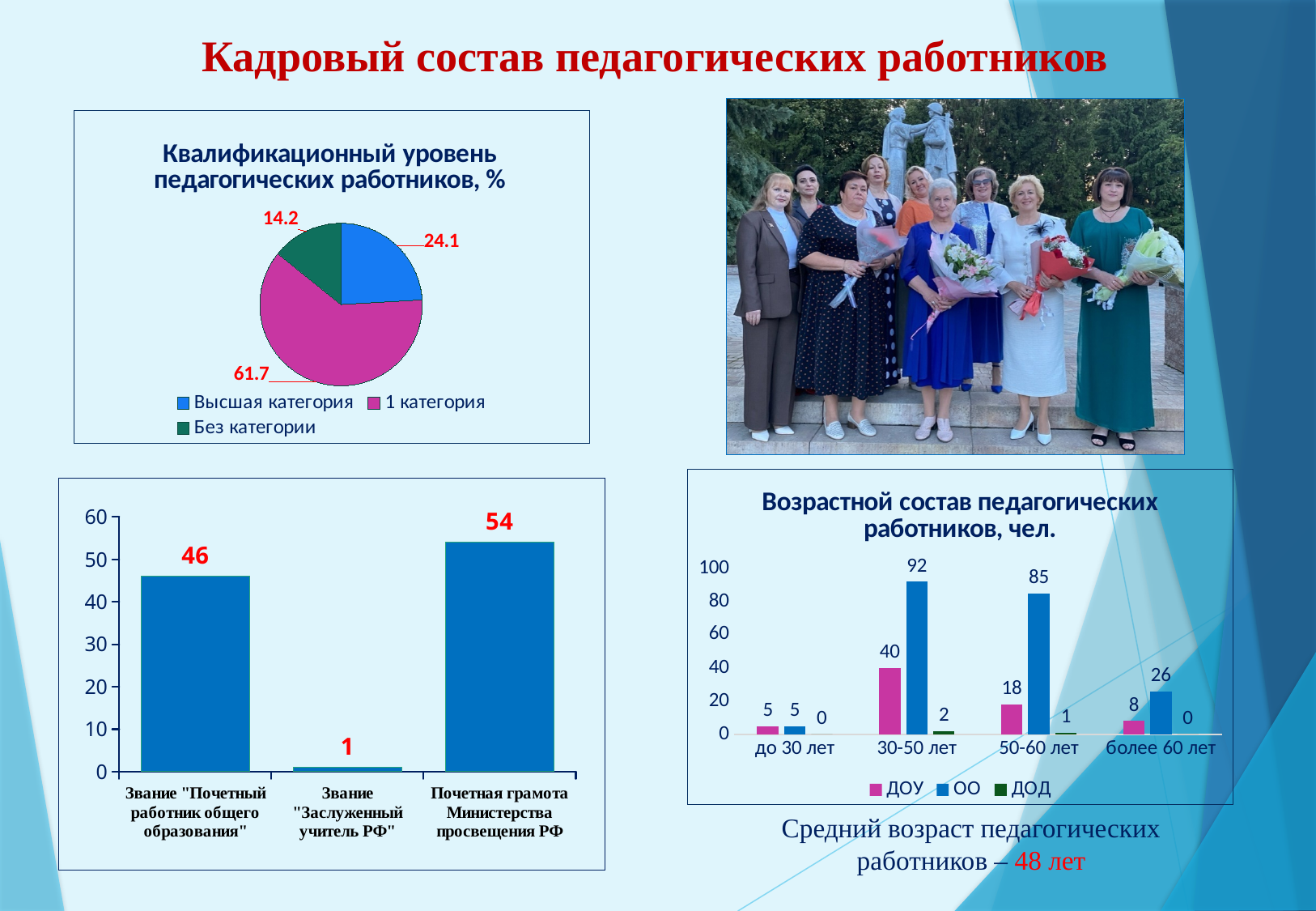
How many series does the legend of the chart "Возрастной состав педагогических работников, чел." list? 3 In the pie chart "Квалификационный уровень педагогических работников, %", what is the value for "1 категория"? 61.7 In the bar chart at the bottom left of the slide, what is the difference between "Почетная грамота Министерства просвещения РФ" and "Звание "Почетный работник общего образования""? 8 In the bar chart at the bottom left of the slide, what is the value for "Почетная грамота Министерства просвещения РФ"? 54 In the bar chart at the bottom left of the slide, which category has the lowest value? Звание "Заслуженный учитель РФ" In the pie chart "Квалификационный уровень педагогических работников, %", which category has the smallest slice? Без категории In the chart "Возрастной состав педагогических работников, чел.", what is the value for ДОУ in the "50-60 лет" group? 18 What kind of chart is the chart at the bottom left of the slide? bar chart In the chart "Возрастной состав педагогических работников, чел.", which is larger: ОО for "50-60 лет" or ОО for "более 60 лет"? ОО for "50-60 лет" In the pie chart "Квалификационный уровень педагогических работников, %", what is the value for "Высшая категория"? 24.1 In the chart "Возрастной состав педагогических работников, чел.", what is the value for ОО in the "30-50 лет" group? 92 How many categories does the legend of the pie chart "Квалификационный уровень педагогических работников, %" list? 3